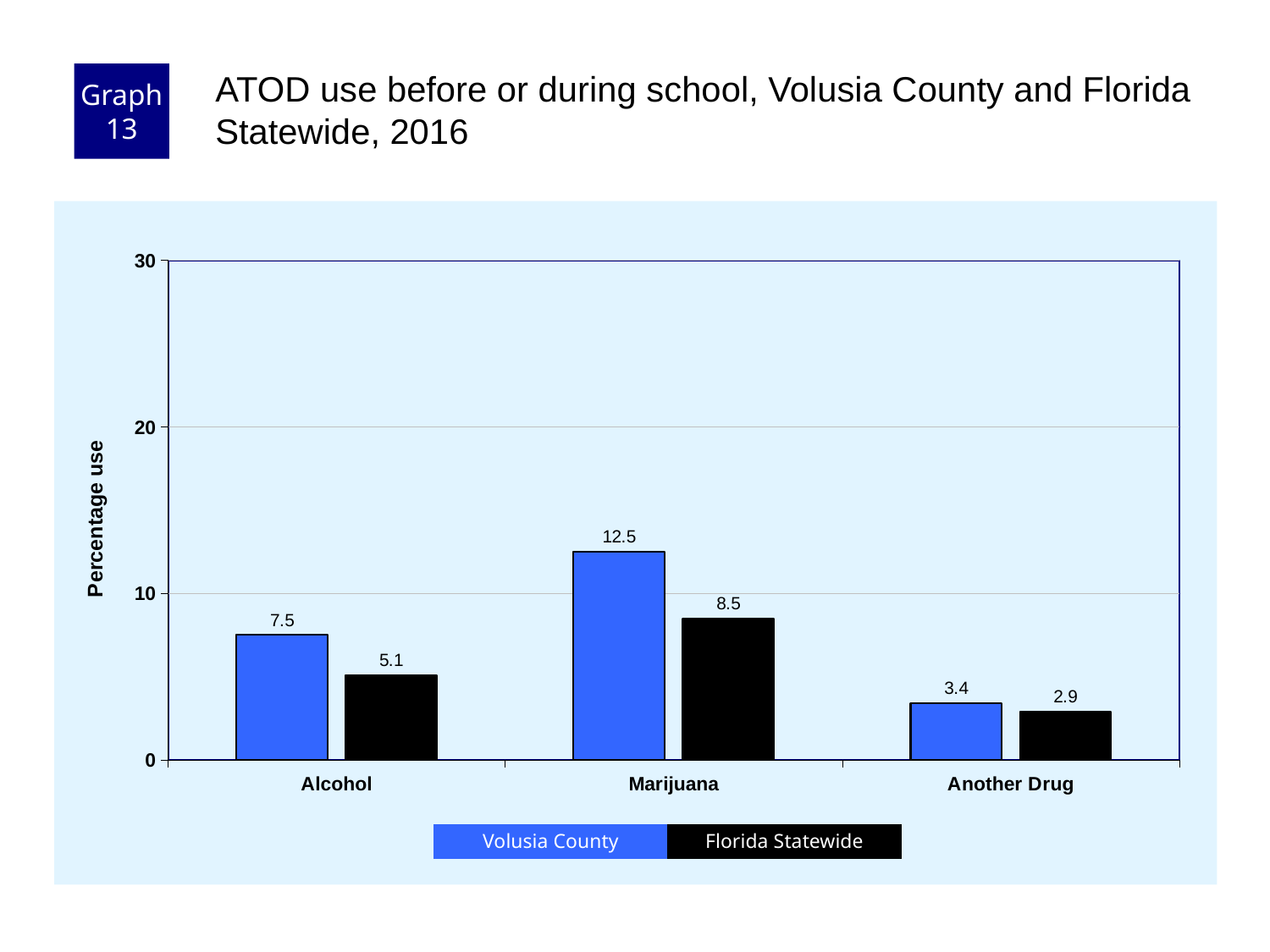
What is the difference between the Volusia County and Florida Statewide values for Marijuana? 4.0 Is the Volusia County value for Marijuana greater or less than 10? greater How many series does the legend list? 2 Which category has the highest Volusia County value? Marijuana Which is larger for Alcohol: the Volusia County value or the Florida Statewide value? Volusia County What is the Florida Statewide value for Another Drug? 2.9 How many categories are shown on the x axis? 3 What kind of chart is shown on the slide? Bar chart What is the Florida Statewide value for Alcohol? 5.1 What is the difference between the Volusia County and Florida Statewide values for Alcohol? 2.4 Which category has the lowest Florida Statewide value? Another Drug What is the Volusia County value for Marijuana? 12.5